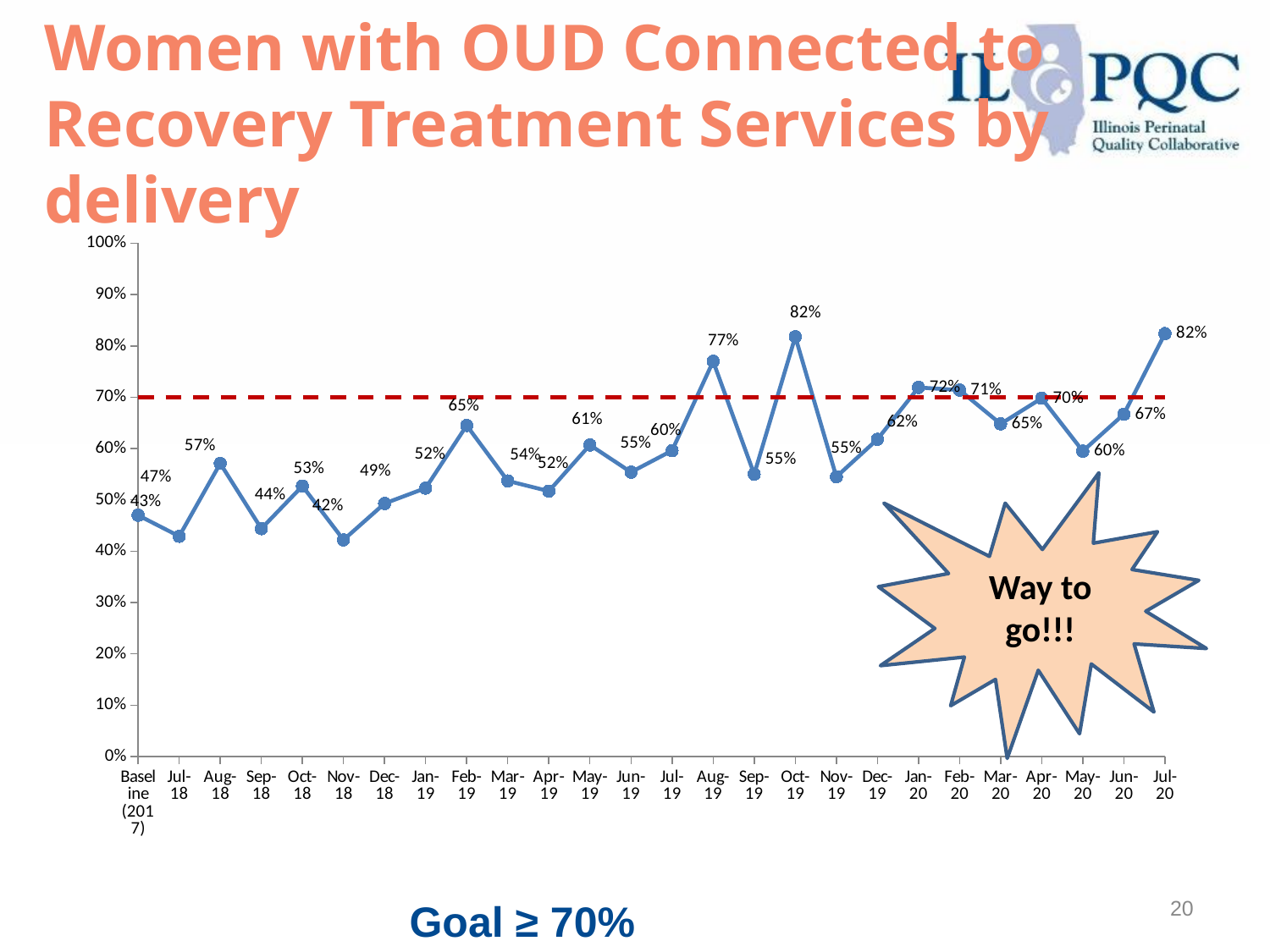
What kind of chart is shown on the slide? Line chart What goal level does the dashed horizontal line mark? 70% What is the value for Nov-18? 42% What is the value for Feb-19? 65% What is the value for Jul-20? 82% Which is larger, the value for Jan-20 or the value for Mar-20? Jan-20 What is the value for Oct-19? 82% What is the value for Aug-19? 77% Is the value for Sep-19 greater or less than 70%? less How many data points are plotted on the chart? 26 What is the difference between the values for Jul-20 and Jun-20? 15% Which month has the lowest value? Nov-18